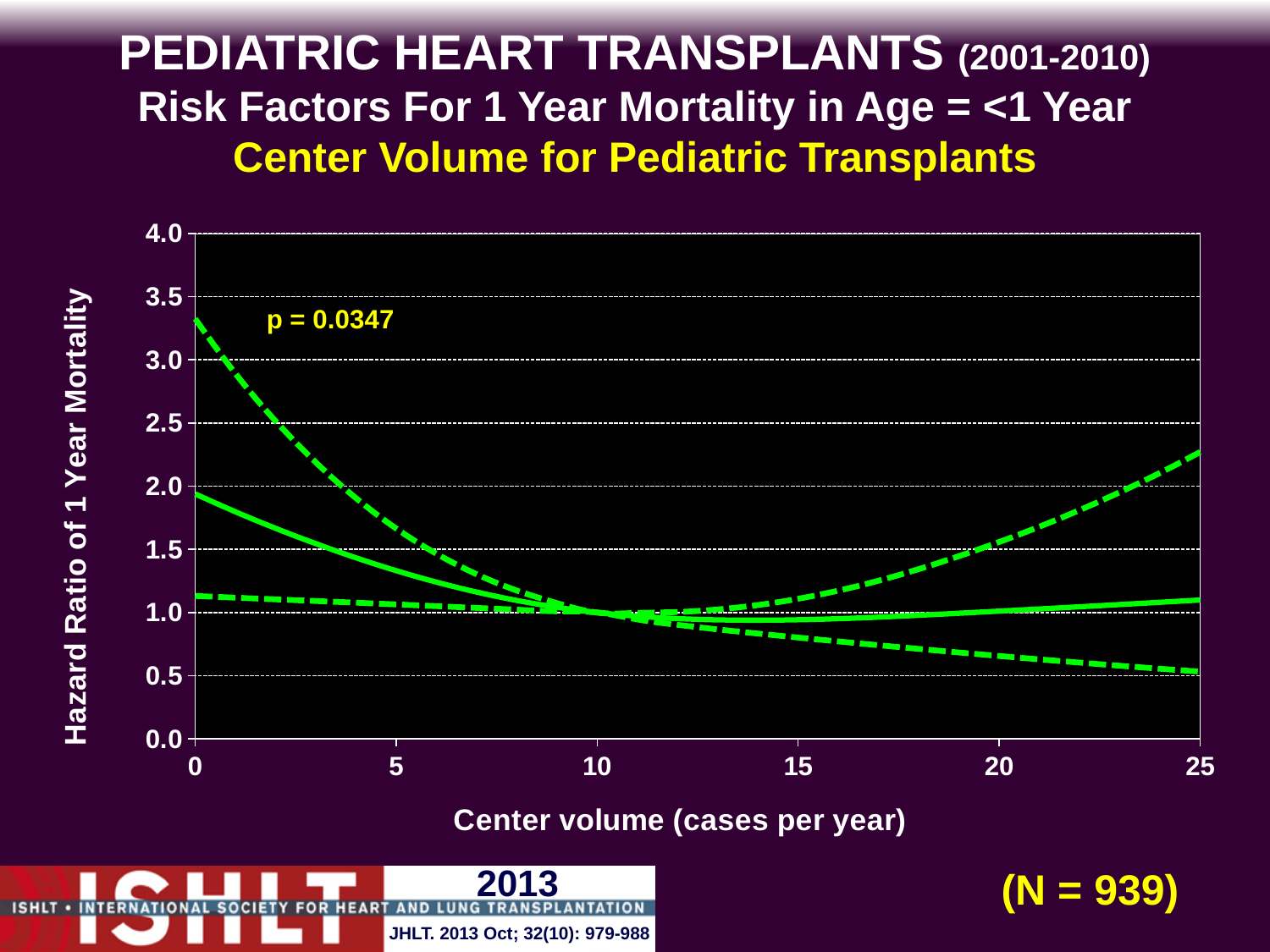
What is the label of the x axis? Center volume (cases per year) Is the value of the solid line at a center volume of 25 greater or less than 1.5? less What kind of chart is shown on the slide? line chart Is the value of the solid line at a center volume of 0 greater or less than 1.5? greater What p-value is printed on the chart? p = 0.0347 Is the value of the upper dashed line at a center volume of 25 greater or less than 2.0? greater Does the upper dashed line rise or fall as center volume increases from 10 to 25 cases per year? rise How many lines are plotted on the chart? 3 Does the solid line rise or fall as center volume increases from 0 to 10 cases per year? fall